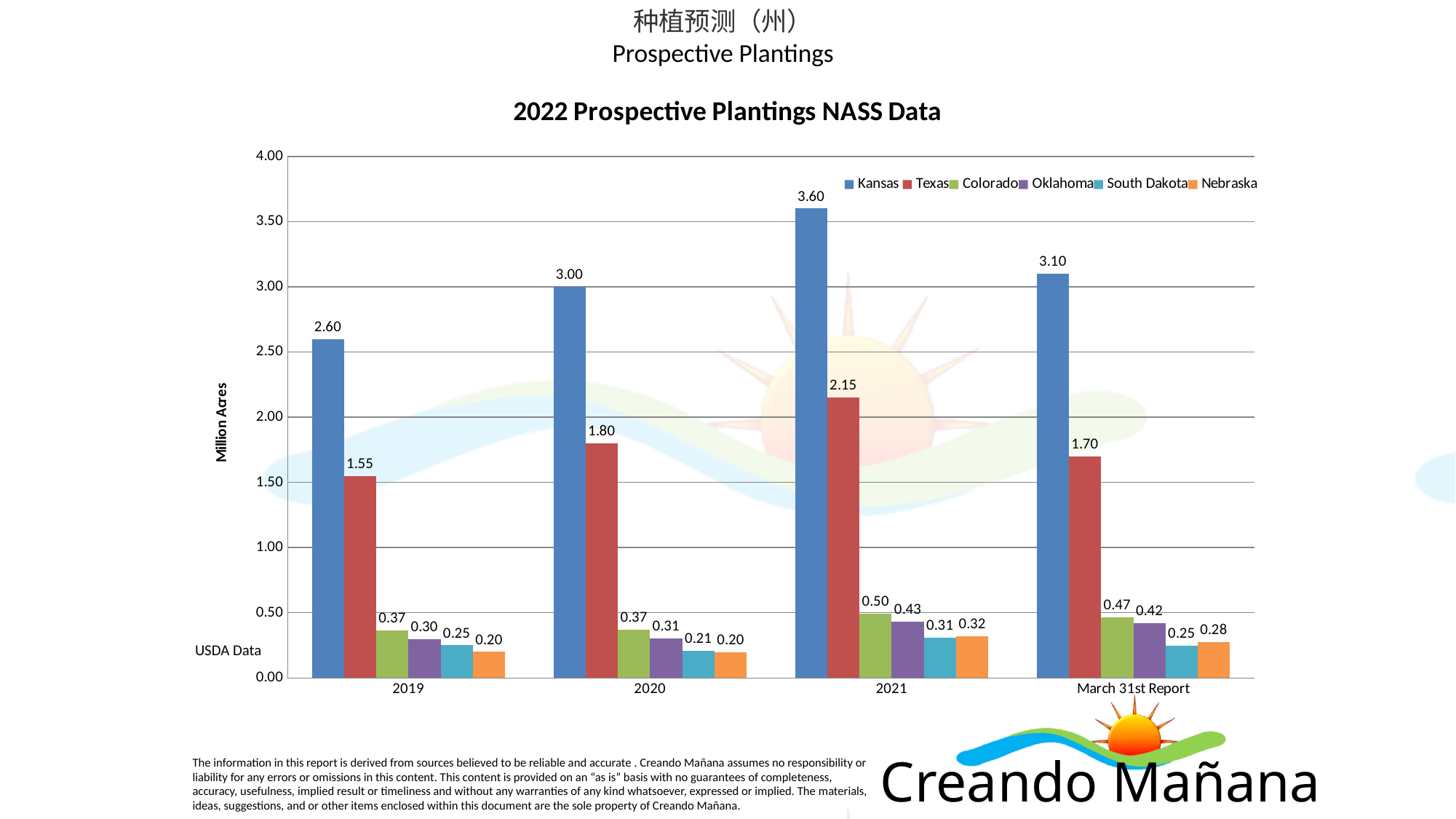
Which is larger in 2021: Oklahoma or South Dakota? Oklahoma What is the difference between the Kansas and Texas values in 2020? 1.20 In which year or report does Kansas reach its highest value? 2021 Which state has the lowest value in 2020? Nebraska What kind of chart is shown? bar chart What is the value for Kansas in 2021? 3.60 What is the y-axis label of the chart? Million Acres Is the value for Kansas in 2019 greater or less than 2.50? greater What is the value for Texas in the March 31st Report? 1.70 How many categories are shown on the x axis? 4 What is the value for Nebraska in 2019? 0.20 How many series does the legend list? 6